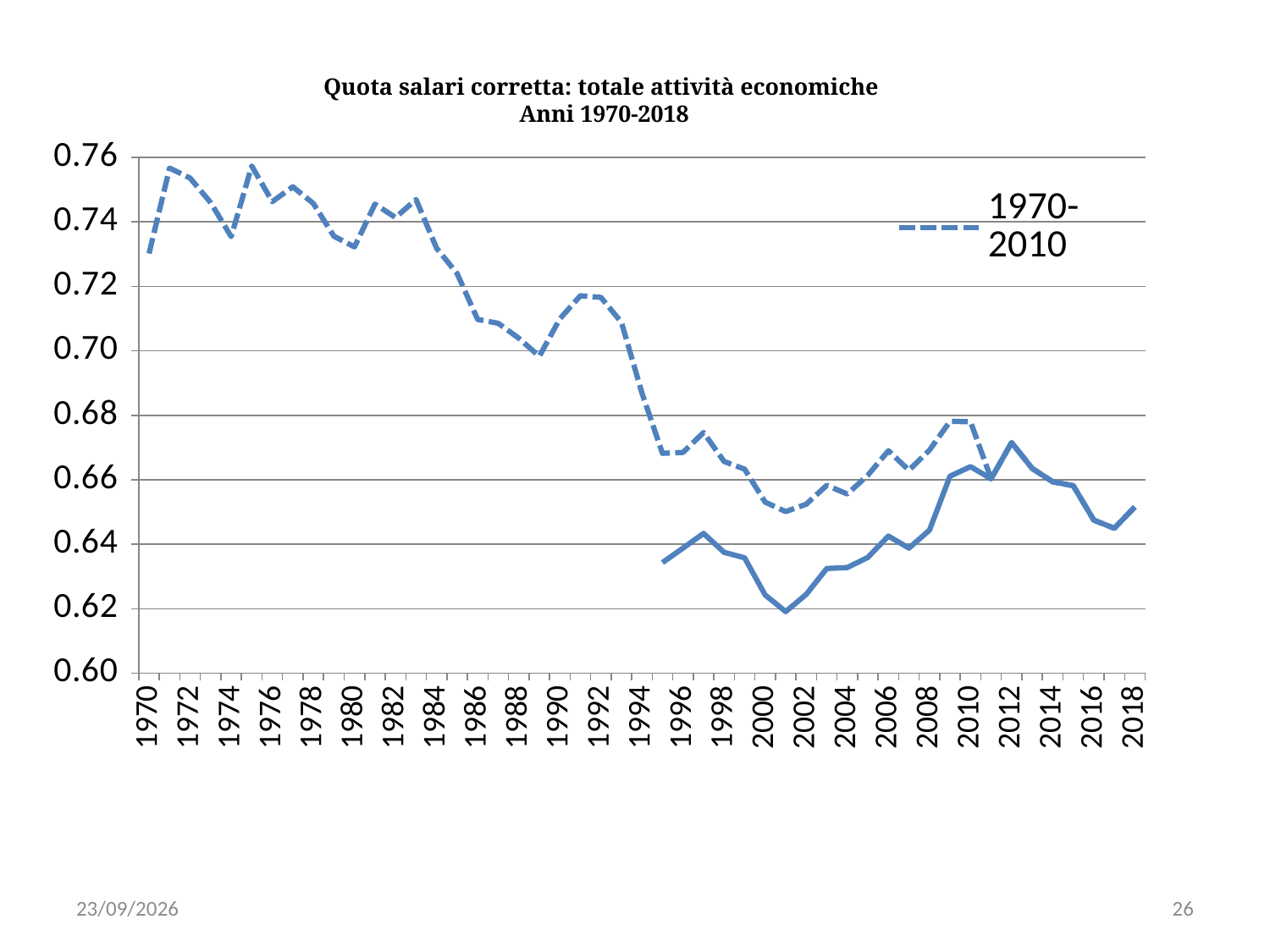
Is the value of the dashed 1970-2010 line in 2001 greater or less than 0.66? less Does the dashed 1970-2010 line overall rise or fall from 1970 to 2010? fall What is the title of the chart? Quota salari corretta: totale attività economiche Anni 1970-2018 In which year does the solid line reach its lowest value? 2001 Is the value of the solid line in 2012 greater or less than 0.66? greater How many series does the chart's legend list? 1 Is the value of the solid line in 2018 greater or less than 0.64? greater What is the legend entry shown for the dashed line? 1970-2010 Does the solid line rise or fall from 2001 to 2012? rise For the dashed 1970-2010 line, which year has the larger value, 1975 or 1995? 1975 What kind of chart is shown on the slide? line chart